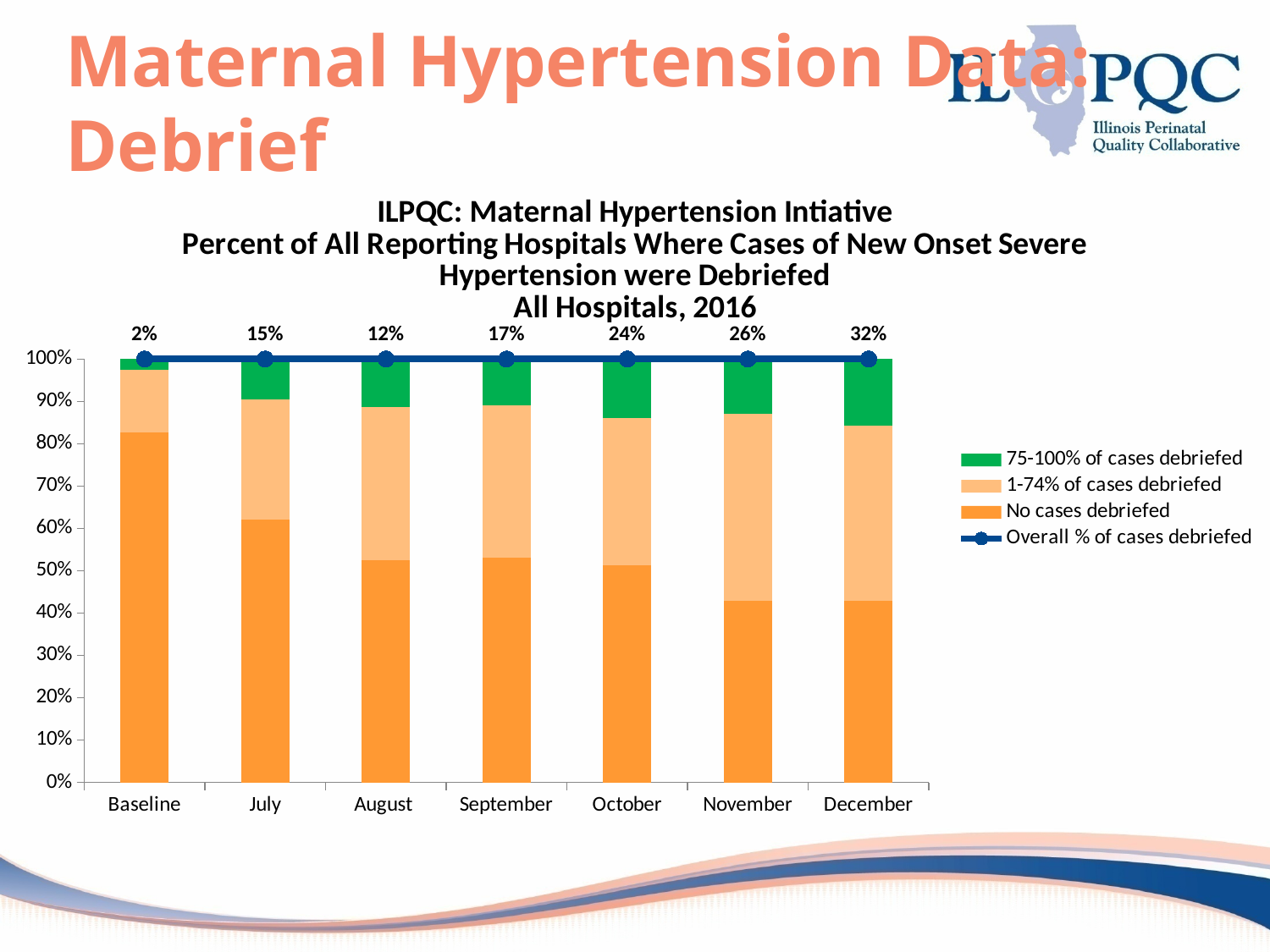
How many categories are shown on the x axis? 7 What kind of chart is this? Stacked bar chart with a line Is the 'No cases debriefed' value at Baseline greater or less than 70%? greater Which month has the highest Overall % of cases debriefed? December Is the 'No cases debriefed' value for December greater or less than 50%? less Which has a higher Overall % of cases debriefed, August or October? October What is the difference between the Overall % of cases debriefed in December and at Baseline? 30% Which category has the lowest Overall % of cases debriefed? Baseline How many series does the legend list? 4 What is the Overall % of cases debriefed for October? 24% What is the Overall % of cases debriefed at Baseline? 2% What is the Overall % of cases debriefed for December? 32%